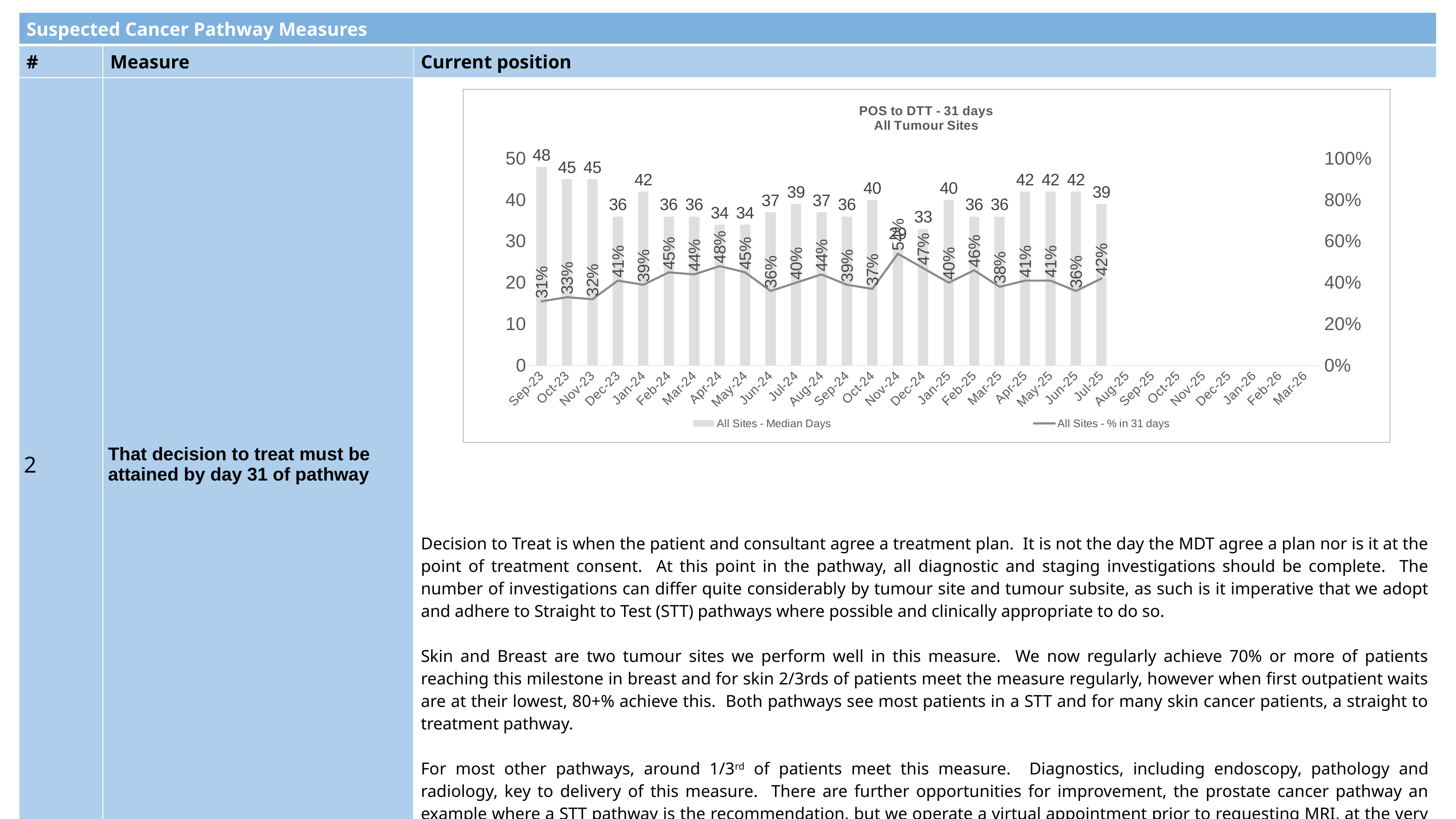
Which month has the lowest % in 31 days value? Sep-23 Which series is shown as a line rather than bars? All Sites - % in 31 days Which is larger, the median days for Jan-24 or for Dec-23? Jan-24 What is the median days value for Jul-25? 39 Which month has the highest median days value? Sep-23 What is the title of the chart? POS to DTT - 31 days All Tumour Sites What is the difference in median days between Sep-23 and Jul-25? 9 How many series does the legend list? 2 What is the median days value for Sep-23? 48 What percentage of patients were within 31 days in Apr-24? 48% Is the median days value for Apr-24 greater or less than 40? less What is the % in 31 days value for Jul-25? 42%